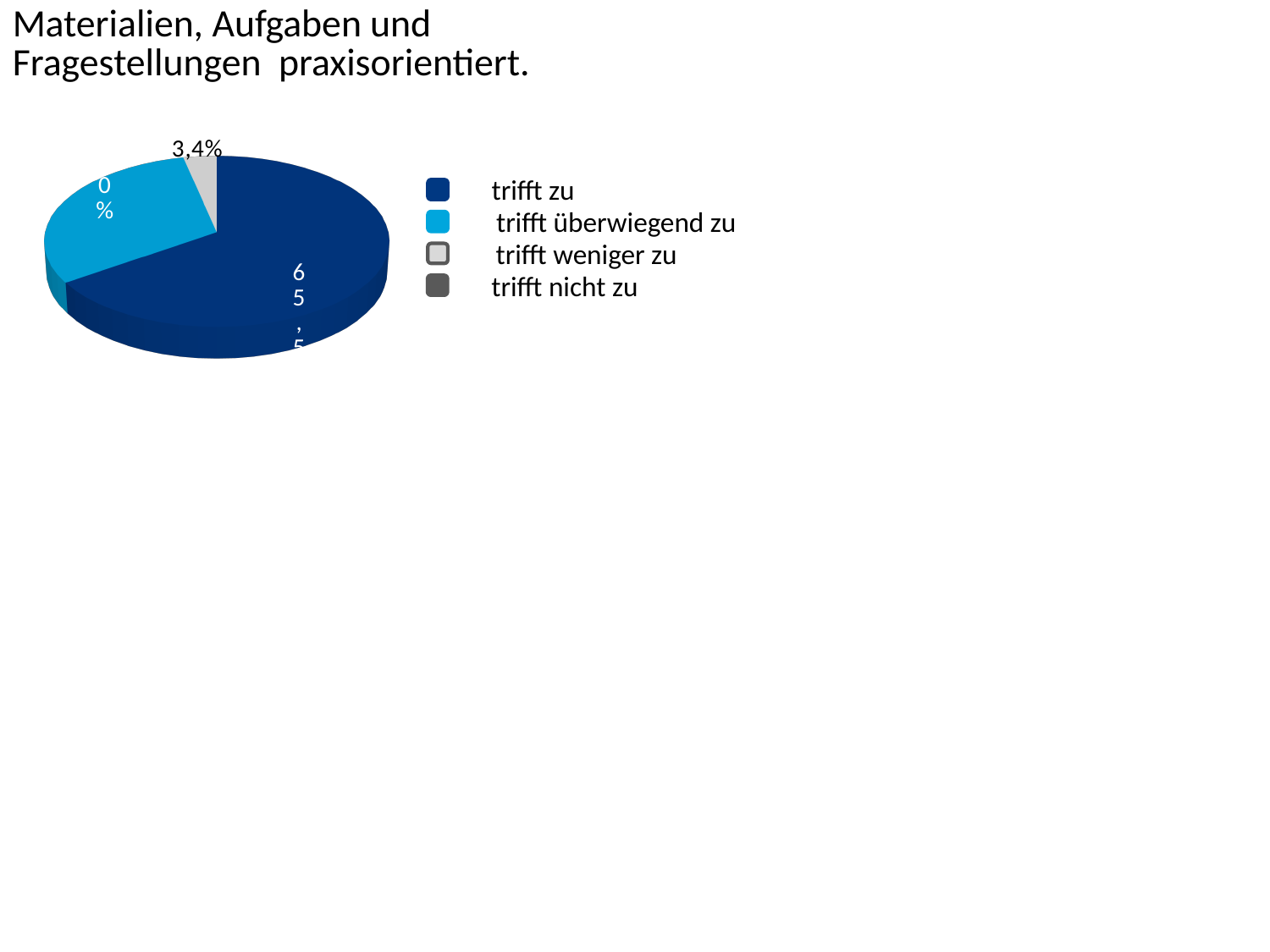
What percentage is shown for the "trifft weniger zu" slice? 3,4% What kind of chart is shown on the slide? pie chart What is the title text above the pie chart? Materialien, Aufgaben und Fragestellungen praxisorientiert. Is the share of the "trifft zu" slice greater or less than 50%? greater Which category has the largest slice of the pie? trifft zu Which slice is larger, "trifft überwiegend zu" or "trifft weniger zu"? trifft überwiegend zu How many entries does the legend of the pie chart list? 4 Which slice is larger, "trifft zu" or "trifft überwiegend zu"? trifft zu Is the share of the "trifft weniger zu" slice greater or less than 10%? less What colour is used for the "trifft zu" category in the pie chart? dark blue